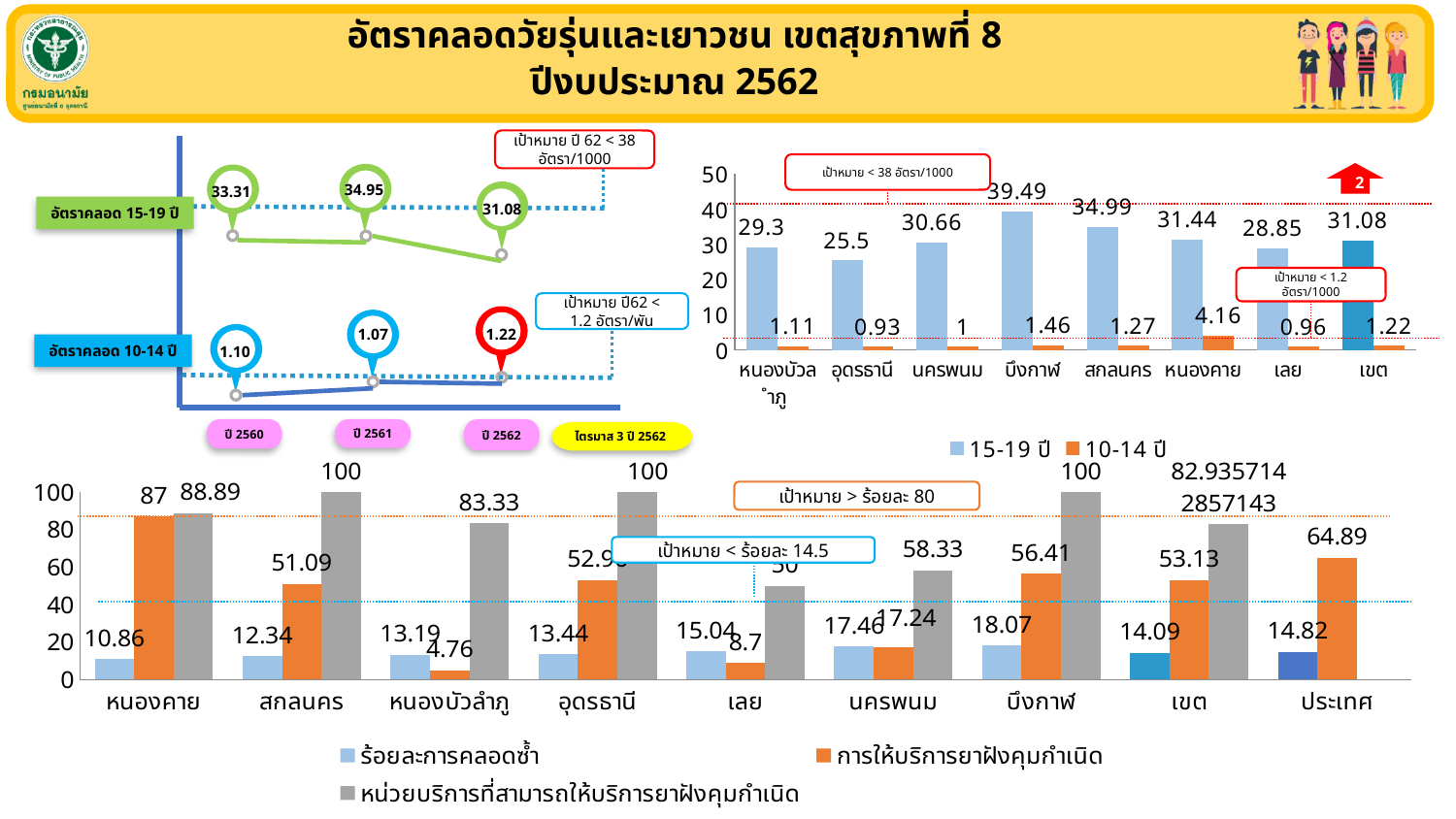
In the bottom bar chart, how many series does the legend list? 3 In the top-right bar chart, which category has the lowest value in the 15-19 ปี series? อุดรธานี In the top-left line chart, what is the value of อัตราคลอด 10-14 ปี for ปี 2562? 1.22 In the top-right bar chart, what is the value for บึงกาฬ in the 15-19 ปี series? 39.49 In the top-right bar chart, what is the value for หนองคาย in the 10-14 ปี series? 4.16 In the top-right bar chart, which category has the highest value in the 15-19 ปี series? บึงกาฬ In the bottom bar chart, what is the value of การให้บริการยาฝังคุมกำเนิด for หนองคาย? 87 In the bottom bar chart, which is larger: การให้บริการยาฝังคุมกำเนิด for ประเทศ or for เขต? ประเทศ In the bottom bar chart, is the value of ร้อยละการคลอดซ้ำ for บึงกาฬ greater or less than 20? less In the bottom bar chart, which category has the lowest value for การให้บริการยาฝังคุมกำเนิด? หนองบัวลำภู In the top-right bar chart, how many categories are shown on the x axis? 8 In the top-right bar chart, what is the difference between the 15-19 ปี values for บึงกาฬ and อุดรธานี? 13.99